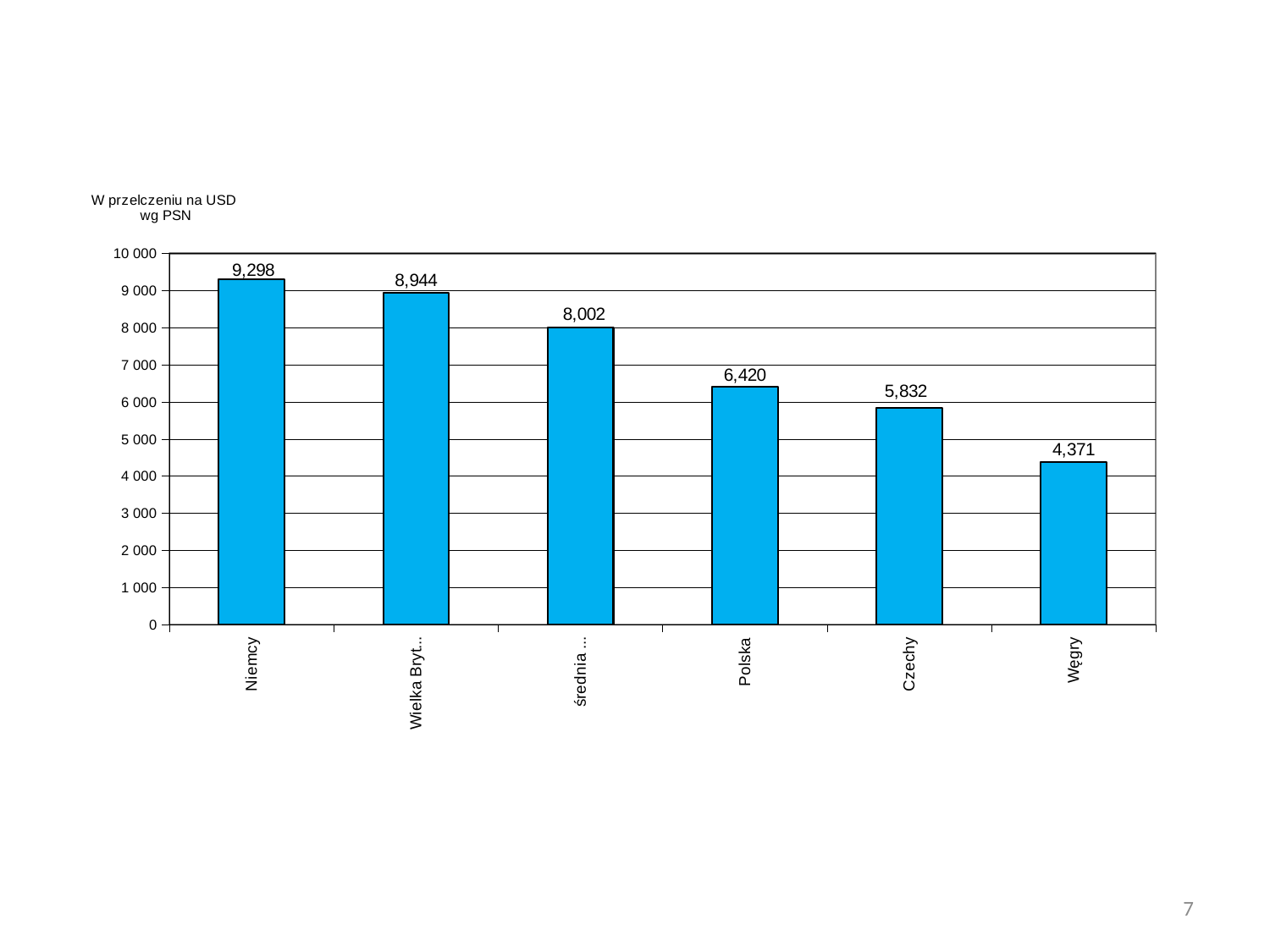
What is the difference between the values for Niemcy and Węgry? 4,927 What is the value for Polska? 6,420 What kind of chart is shown on the slide? Bar chart What is the value for Czechy? 5,832 Which category has the highest value? Niemcy What is the difference between the values for Polska and Czechy? 588 Do the values rise or fall from left to right along the x axis? Fall How many bars are shown in the chart? 6 Which category has the lowest value? Węgry What is the value for Niemcy? 9,298 Which is larger, the value for Polska or the value for Czechy? Polska What is the value for Węgry? 4,371